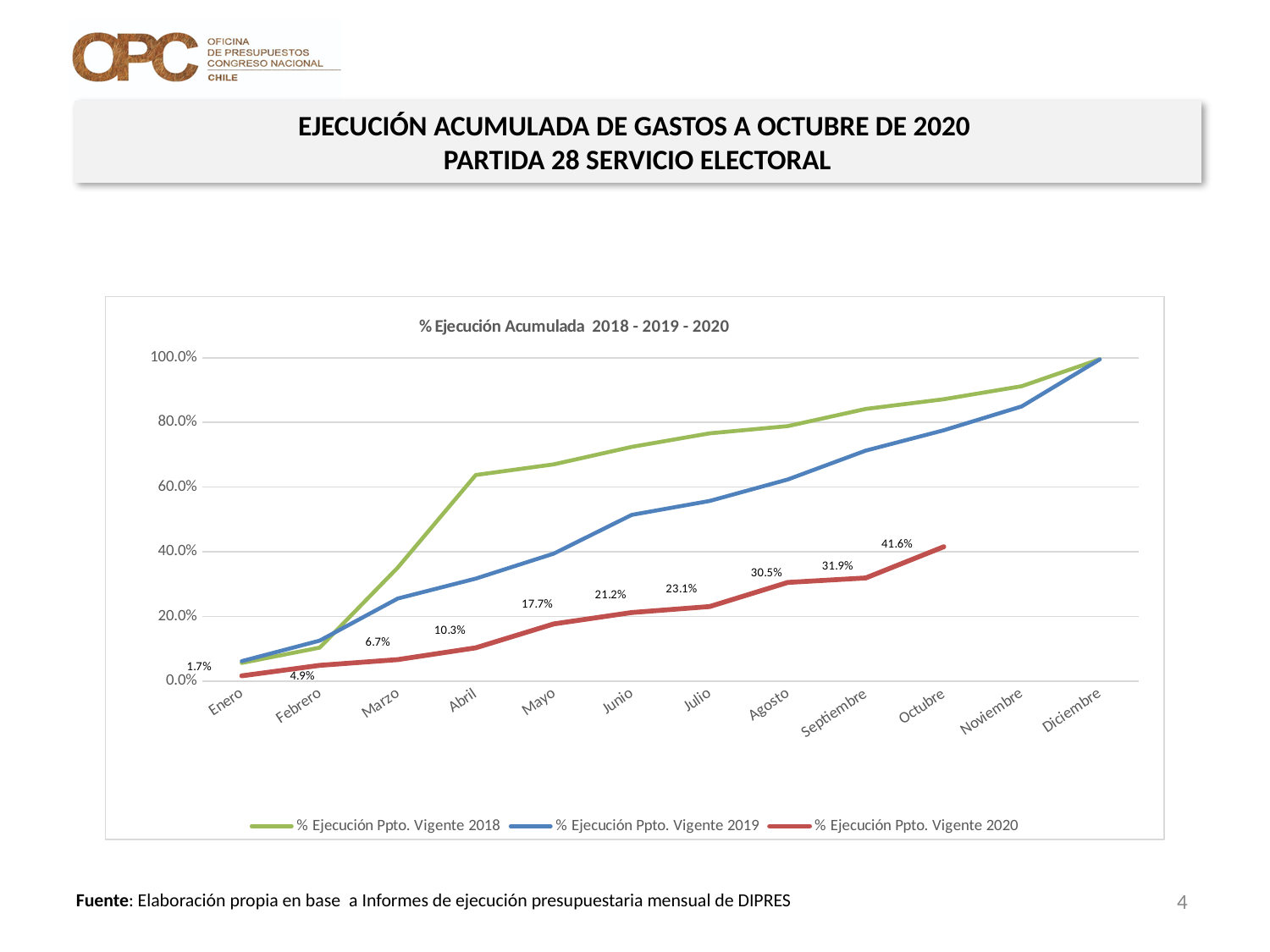
Which month has the lowest value for % Ejecución Ppto. Vigente 2020? Enero What is the difference between the 2020 values for Octubre and Septiembre? 9.7% What is the value of % Ejecución Ppto. Vigente 2020 in Enero? 1.7% What is the value of % Ejecución Ppto. Vigente 2020 in Octubre? 41.6% Which series is higher in Junio, % Ejecución Ppto. Vigente 2018 or % Ejecución Ppto. Vigente 2019? % Ejecución Ppto. Vigente 2018 What type of chart is shown on the slide? Line chart Is the value for % Ejecución Ppto. Vigente 2018 in Abril greater or less than 60.0%? greater What is the value of % Ejecución Ppto. Vigente 2020 in Mayo? 17.7% Which month has the highest value for % Ejecución Ppto. Vigente 2020? Octubre Does the % Ejecución Ppto. Vigente 2020 line rise or fall from Enero to Octubre? Rise How many series does the legend list? 3 What is the title of the chart? % Ejecución Acumulada 2018 - 2019 - 2020